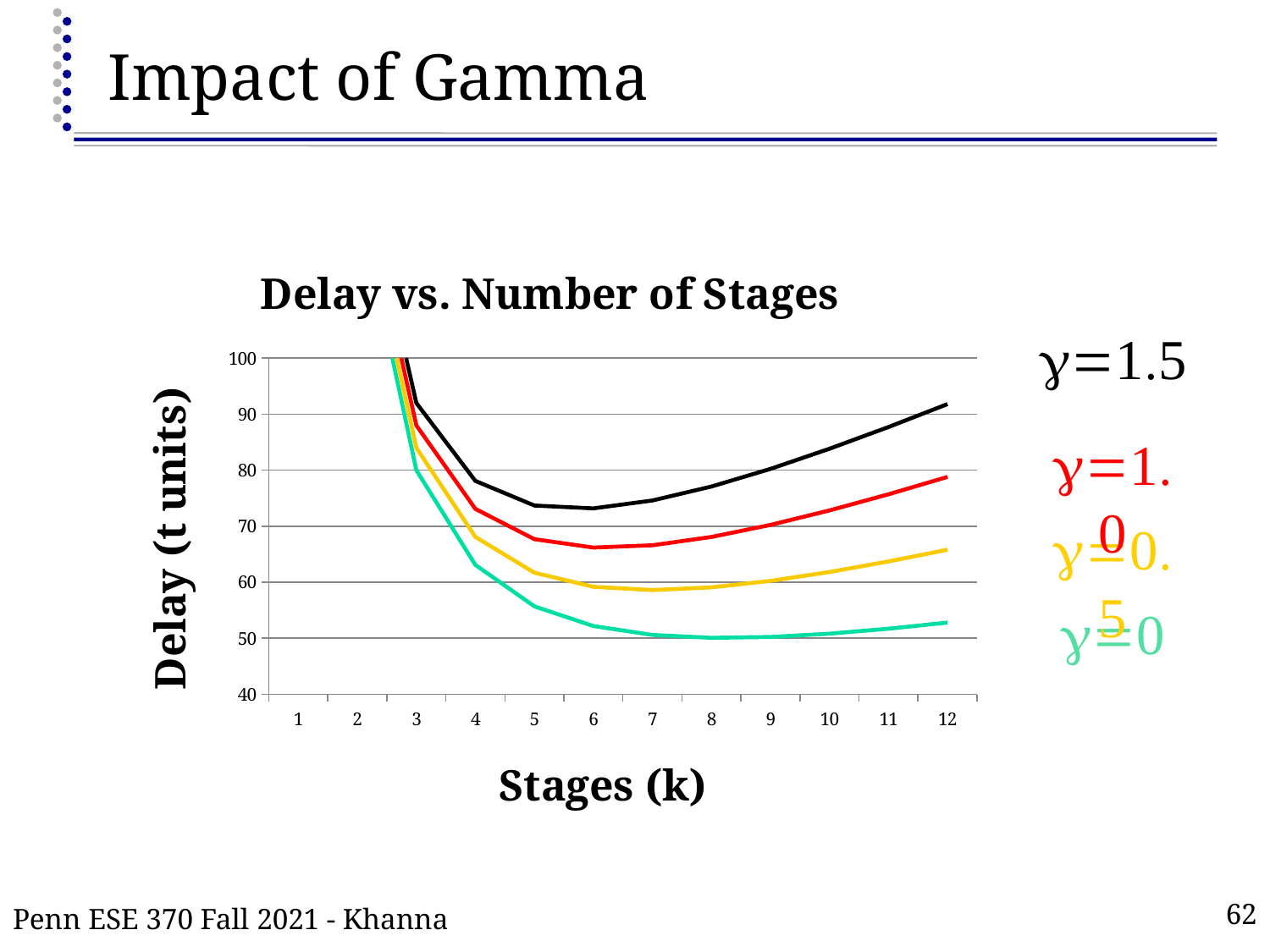
Which gamma value has the lowest delay line on the chart? γ=0 At 12 stages, which has the larger delay: γ=1.0 or γ=0.5? γ=1.0 Is the delay for γ=1.5 at 12 stages greater or less than 80? greater Which gamma value has the highest delay line on the chart? γ=1.5 What is the label of the x axis of the chart? Stages (k) Is the delay for γ=0 at 12 stages greater or less than 60? less What is the title of the chart? Delay vs. Number of Stages Does the delay for γ=1.5 rise or fall as the number of stages increases from 8 to 12? rise What kind of chart is shown on the slide? Line chart How many stage values are marked along the x axis? 12 Is the delay for γ=1.5 at 6 stages greater or less than 70? greater How many lines are plotted on the chart? 4